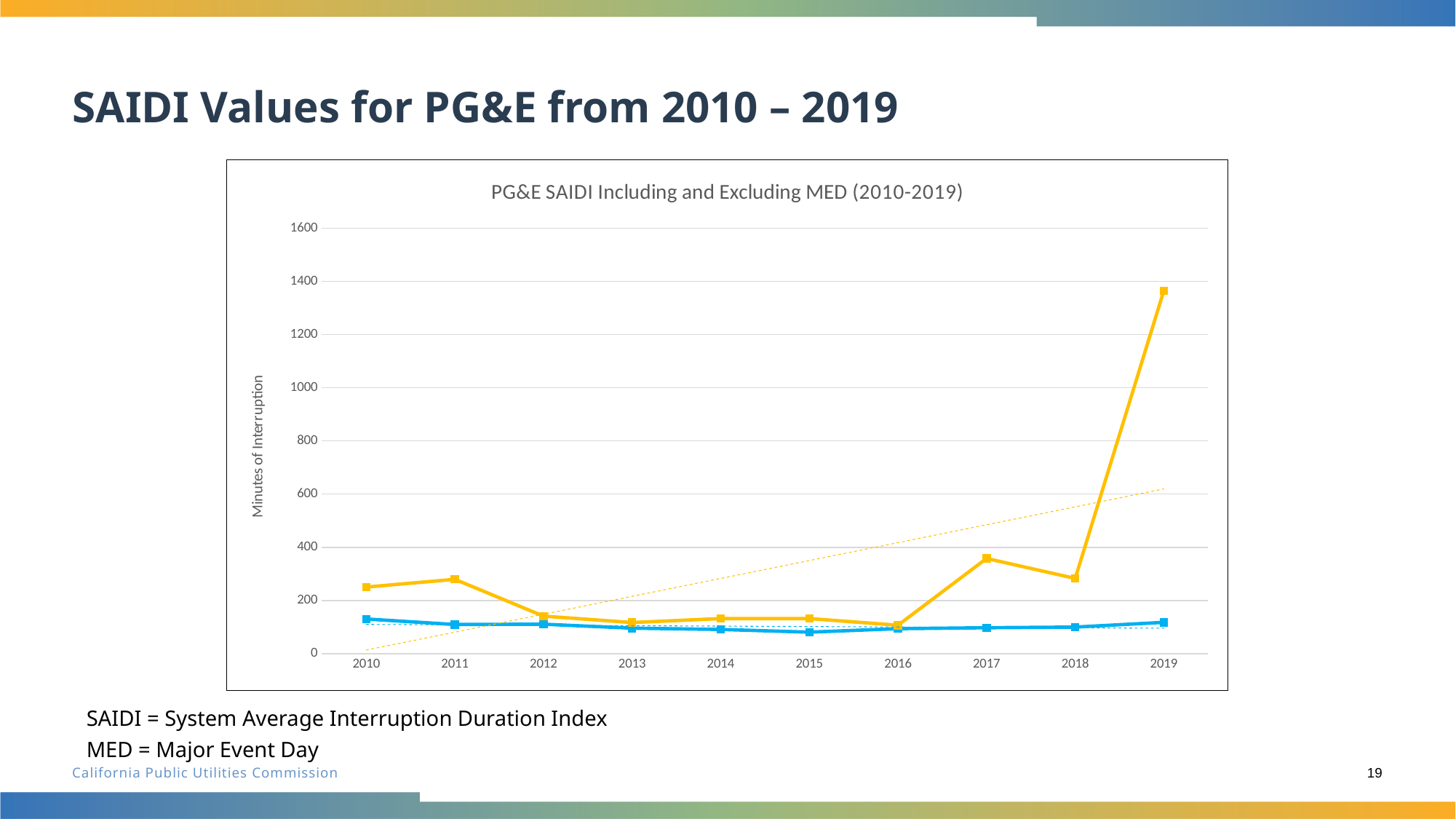
Does the yellow line rise or fall between 2018 and 2019? rise What is the label on the vertical axis of the chart? Minutes of Interruption Is the value of the yellow line in 2019 greater or less than 1200? greater What kind of chart is shown on the slide? line chart How many years are plotted along the x axis of the chart? 10 What is the title of the chart? PG&E SAIDI Including and Excluding MED (2010-2019) Is the value of the yellow line in 2017 greater or less than 200? greater Which year has the larger value on the yellow line, 2010 or 2012? 2010 Is the value of the yellow line in 2012 greater or less than 200? less In which year does the yellow line reach its highest value? 2019 Which year has the larger value on the yellow line, 2018 or 2019? 2019